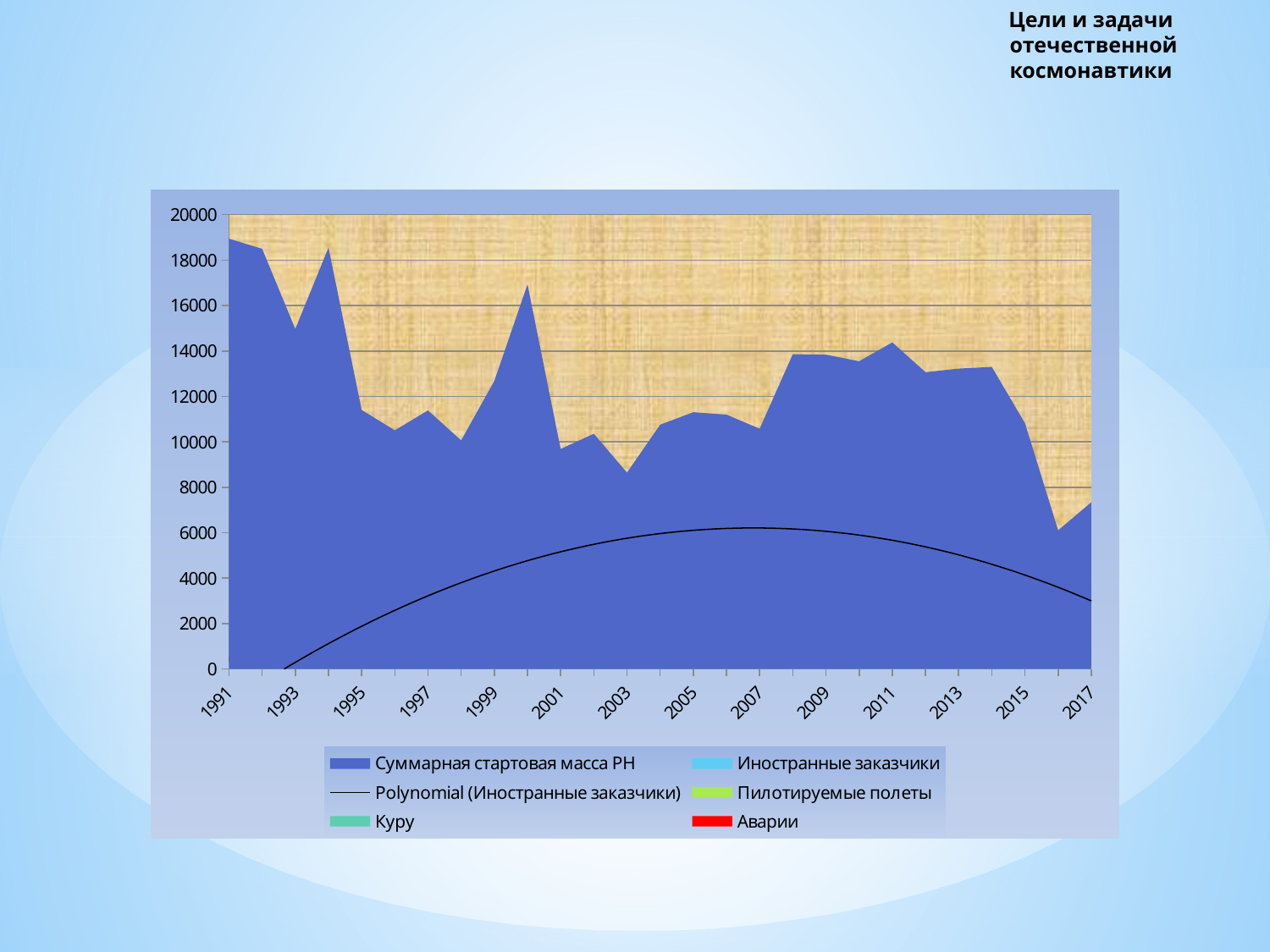
Overall, does the value for Суммарная стартовая масса РН rise or fall from 1991 to 2017? fall Which year has the lowest value for Суммарная стартовая масса РН? 2016 Is the value for Суммарная стартовая масса РН in 2003 greater or less than 10000? less Which is larger, the value for Суммарная стартовая масса РН in 1991 or in 2017? 1991 What is the first year shown on the x axis of the chart? 1991 Is the value for Суммарная стартовая масса РН in 2009 greater or less than 12000? greater Which is larger, the value for Суммарная стартовая масса РН in 2000 or in 2003? 2000 Is the value for Суммарная стартовая масса РН in 2017 greater or less than 8000? less How many entries does the chart legend list? 6 Which year has the highest value for Суммарная стартовая масса РН? 1991 What kind of chart is shown on the slide? area chart